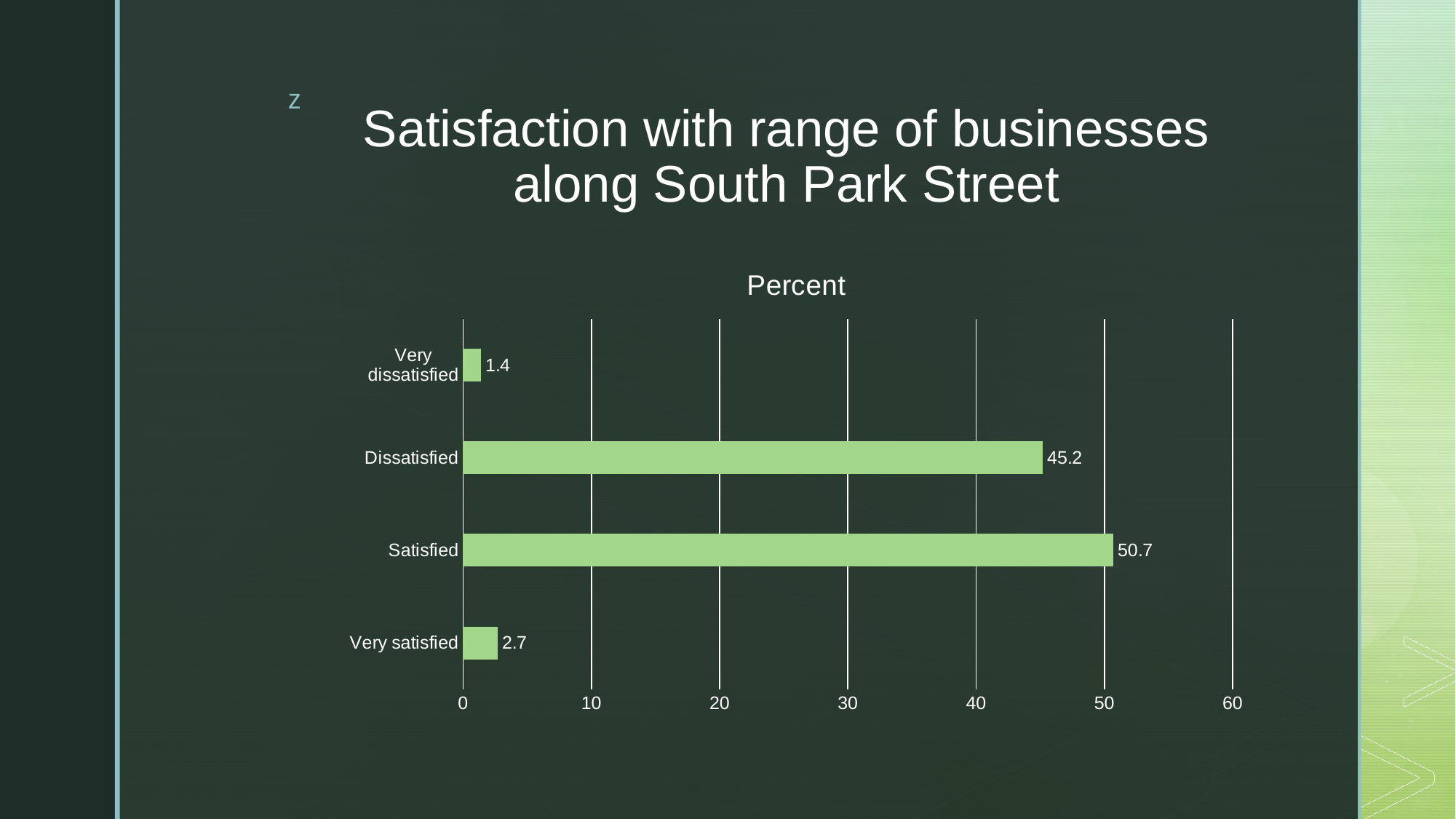
What is the value for Very satisfied? 2.7 What is the difference between the values for Satisfied and Dissatisfied? 5.5 Which category has the highest value? Satisfied Which category has the lowest value? Very dissatisfied What is the value for Very dissatisfied? 1.4 How many categories are shown in the chart? 4 What is the value for Satisfied? 50.7 What is the title of the chart? Percent Which is larger, the value for Very satisfied or the value for Very dissatisfied? Very satisfied Is the value for Dissatisfied greater or less than 40? greater What is the value for Dissatisfied? 45.2 What kind of chart is shown on the slide? bar chart